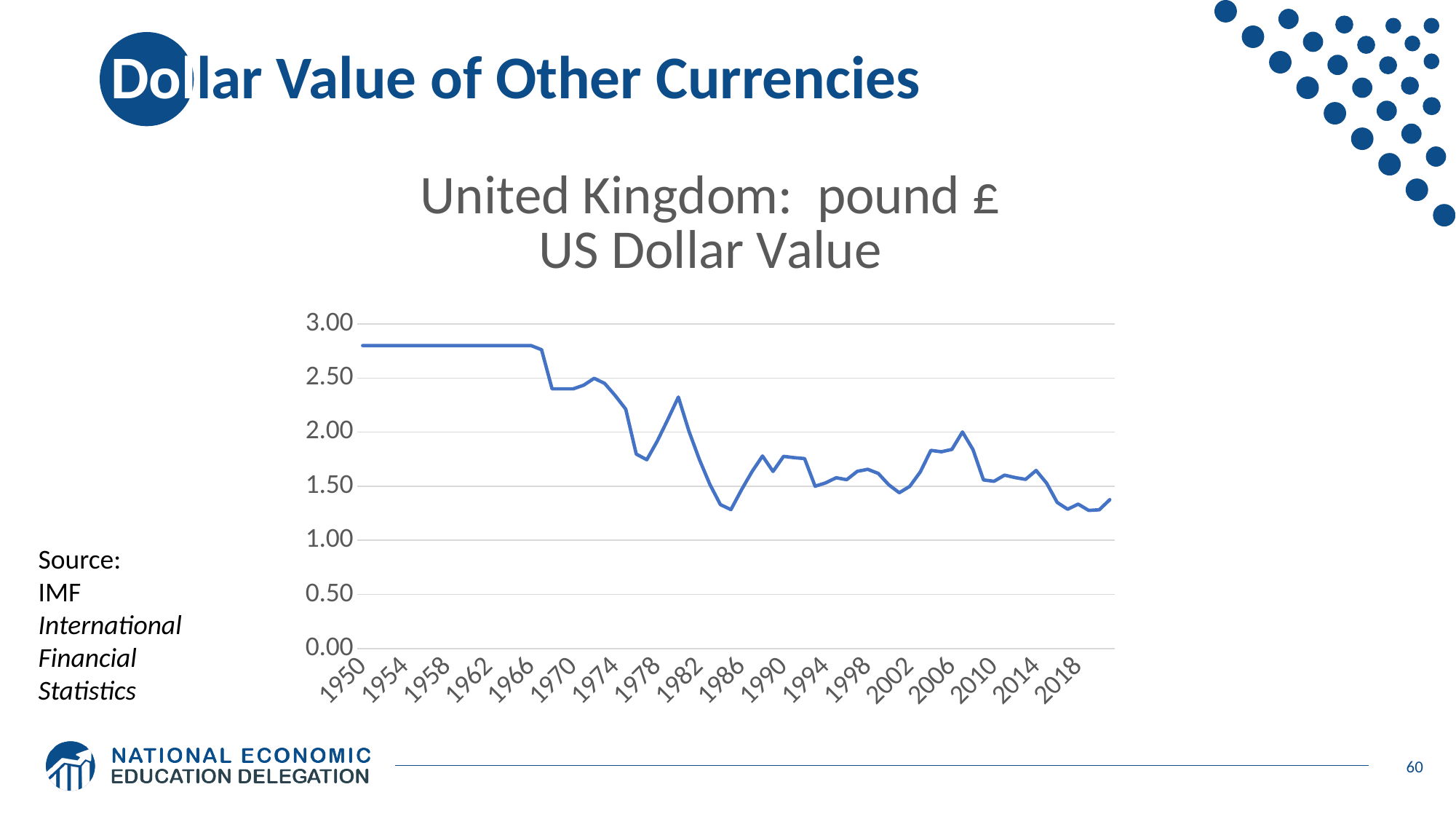
Is the value for 1970 greater or less than 2.00? greater Overall, does the US dollar value of the pound rise or fall from 1950 to 2018? fall What is the highest value shown on the y axis? 3.00 Which year has the larger value, 1950 or 2018? 1950 What kind of chart is shown on the slide? line chart Is the value for 1950 greater or less than 2.50? greater Is the value for 2018 greater or less than 1.50? less How many year labels are shown on the x axis? 18 What is the title of the chart? United Kingdom: pound £ US Dollar Value